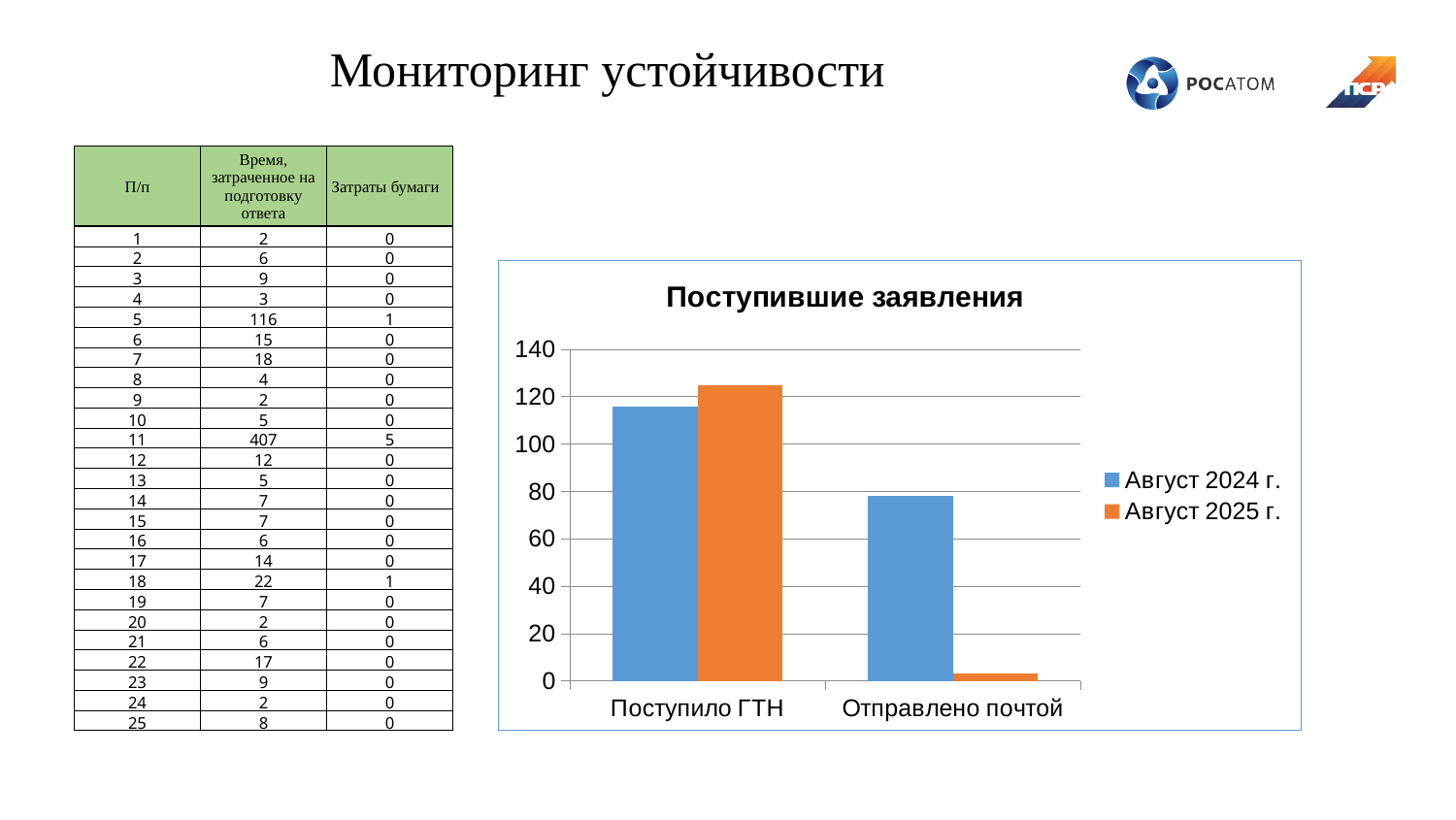
How many categories are shown on the x axis of the chart? 2 Is the value for Поступило ГТН in Август 2024 г. greater or less than 100? greater Which series is shown in orange in the chart? Август 2025 г. Is the value for Отправлено почтой in Август 2025 г. greater or less than 20? less What is the title of the chart on the slide? Поступившие заявления What kind of chart is shown on the slide? bar chart For Отправлено почтой, which series has the larger value, Август 2024 г. or Август 2025 г.? Август 2024 г. Is the value for Поступило ГТН in Август 2025 г. greater or less than 120? greater For Поступило ГТН, which series has the larger value, Август 2024 г. or Август 2025 г.? Август 2025 г. How many series does the chart's legend list? 2 Which category has the lowest value for Август 2025 г.? Отправлено почтой